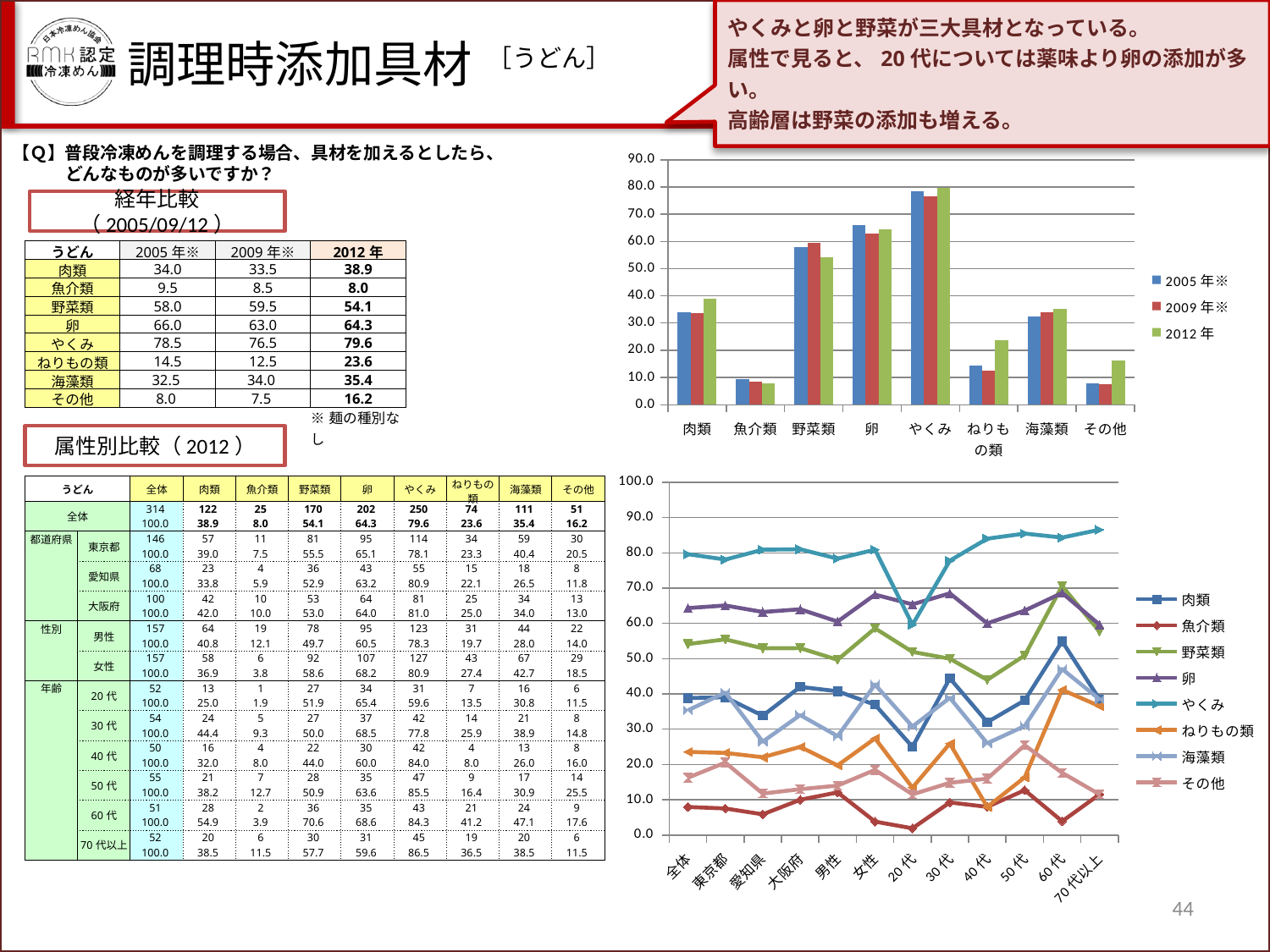
In the top-right bar chart, is the 2012年 value for 魚介類 greater or less than 10? less In the top-right bar chart, is the 2012年 value for ねりもの類 greater or less than 20? greater In the top-right bar chart, which category has the highest bars? やくみ What kind of chart is the bottom-right chart showing 全体, 東京都, 愛知県 and so on? line chart How many categories are on the x axis of the bottom-right line chart? 12 How many series does the legend of the top-right bar chart list? 3 In the bottom-right line chart, which is larger at 20代: やくみ or 卵? 卵 In the bottom-right line chart, is the やくみ value for 70代以上 greater or less than 80? greater What kind of chart is the top-right chart comparing 2005, 2009 and 2012? bar chart How many ingredient categories are shown on the x axis of the top-right bar chart? 8 How many series does the legend of the bottom-right line chart list? 8 In the top-right bar chart, which is larger for 2012年: 野菜類 or 卵? 卵